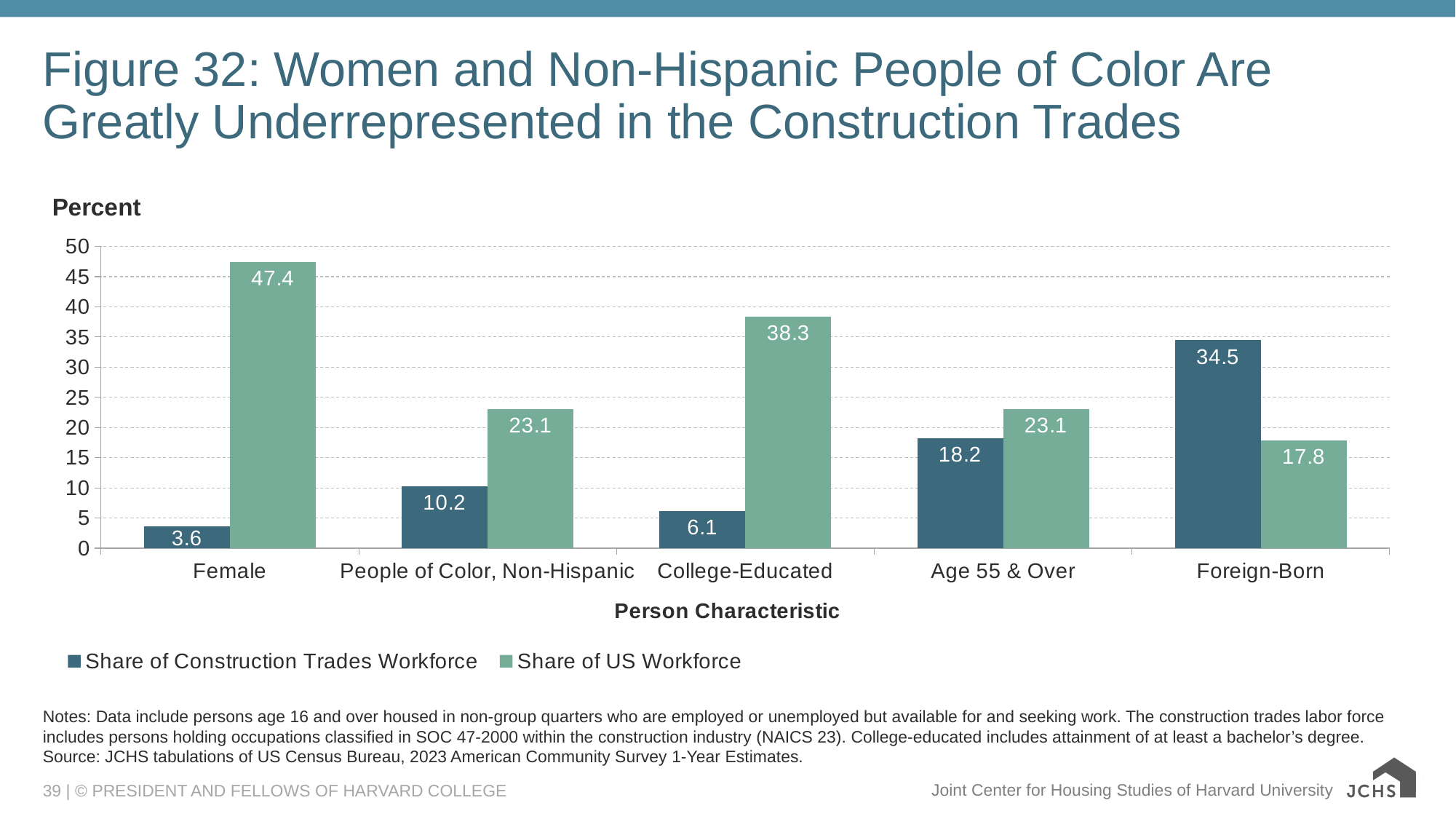
What kind of chart is shown on the slide? Bar chart Which person characteristic has the lowest Share of Construction Trades Workforce? Female Which person characteristic has the highest Share of US Workforce? Female How many series does the legend list? 2 What is the Share of Construction Trades Workforce for Female? 3.6 What is the Share of Construction Trades Workforce for Foreign-Born? 34.5 How many person characteristics are shown on the x axis? 5 What is the Share of US Workforce for College-Educated? 38.3 What is the difference between the Share of US Workforce and the Share of Construction Trades Workforce for Female? 43.8 What is the difference between the Share of US Workforce and the Share of Construction Trades Workforce for People of Color, Non-Hispanic? 12.9 For Foreign-Born, which is larger: the Share of Construction Trades Workforce or the Share of US Workforce? Share of Construction Trades Workforce What is the label of the x axis? Person Characteristic